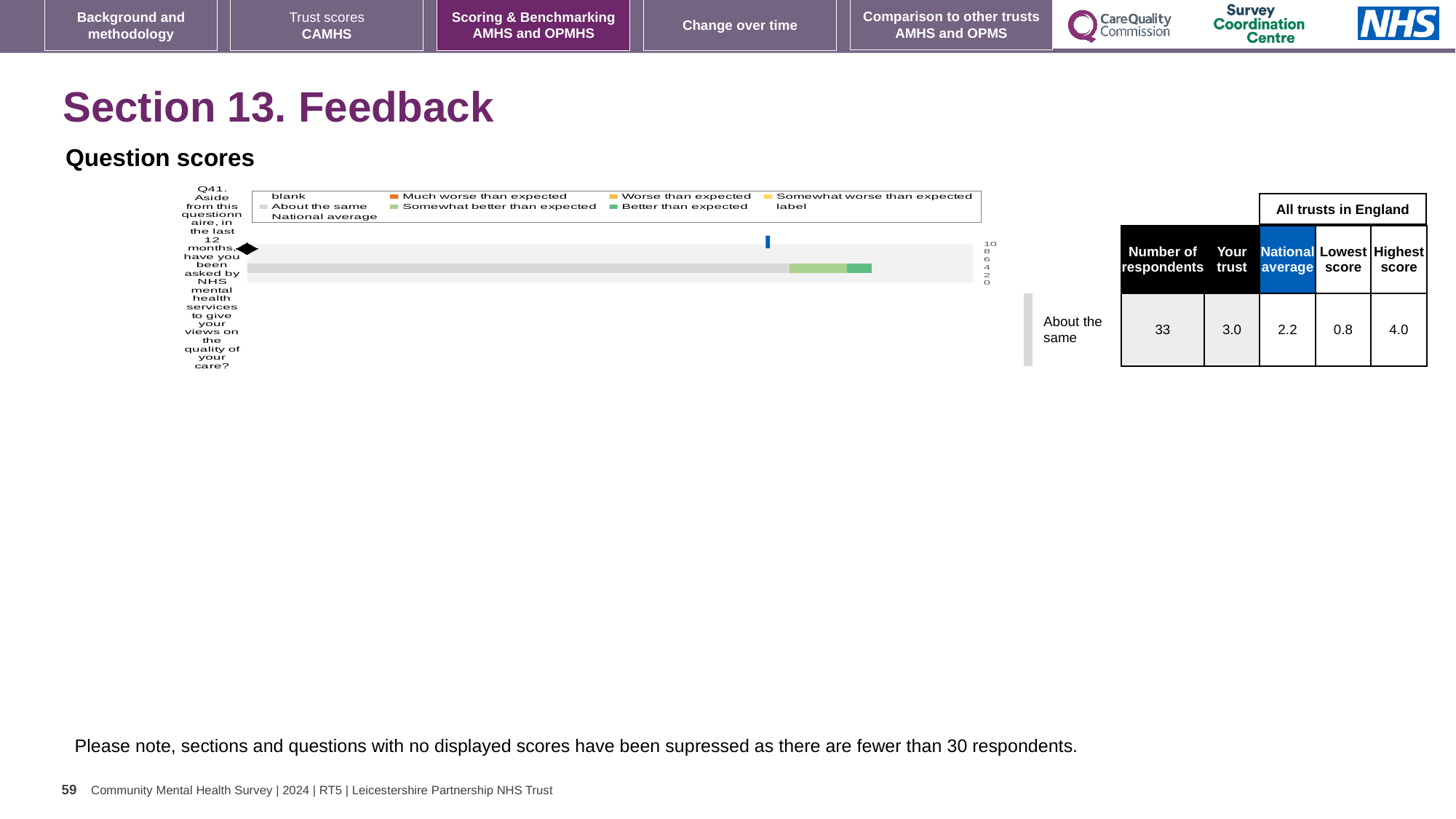
How many respondents answered Q41? 33 What benchmark category label is shown for Q41 next to the chart? About the same What kind of chart is used to show the Q41 question score? bar chart For Q41, how much higher is the 'Your trust' score than the national average? 0.8 How many survey questions are plotted in the Question scores chart? 1 What is the highest score among all trusts in England for Q41? 4.0 For Q41, what is the difference between the highest score and the lowest score among all trusts in England? 3.2 What is the national average score for Q41? 2.2 Which question number is shown in the Question scores chart? Q41 What is the lowest score among all trusts in England for Q41? 0.8 What is the 'Your trust' score for Q41? 3.0 For Q41, which is higher: the 'Your trust' score or the national average? Your trust